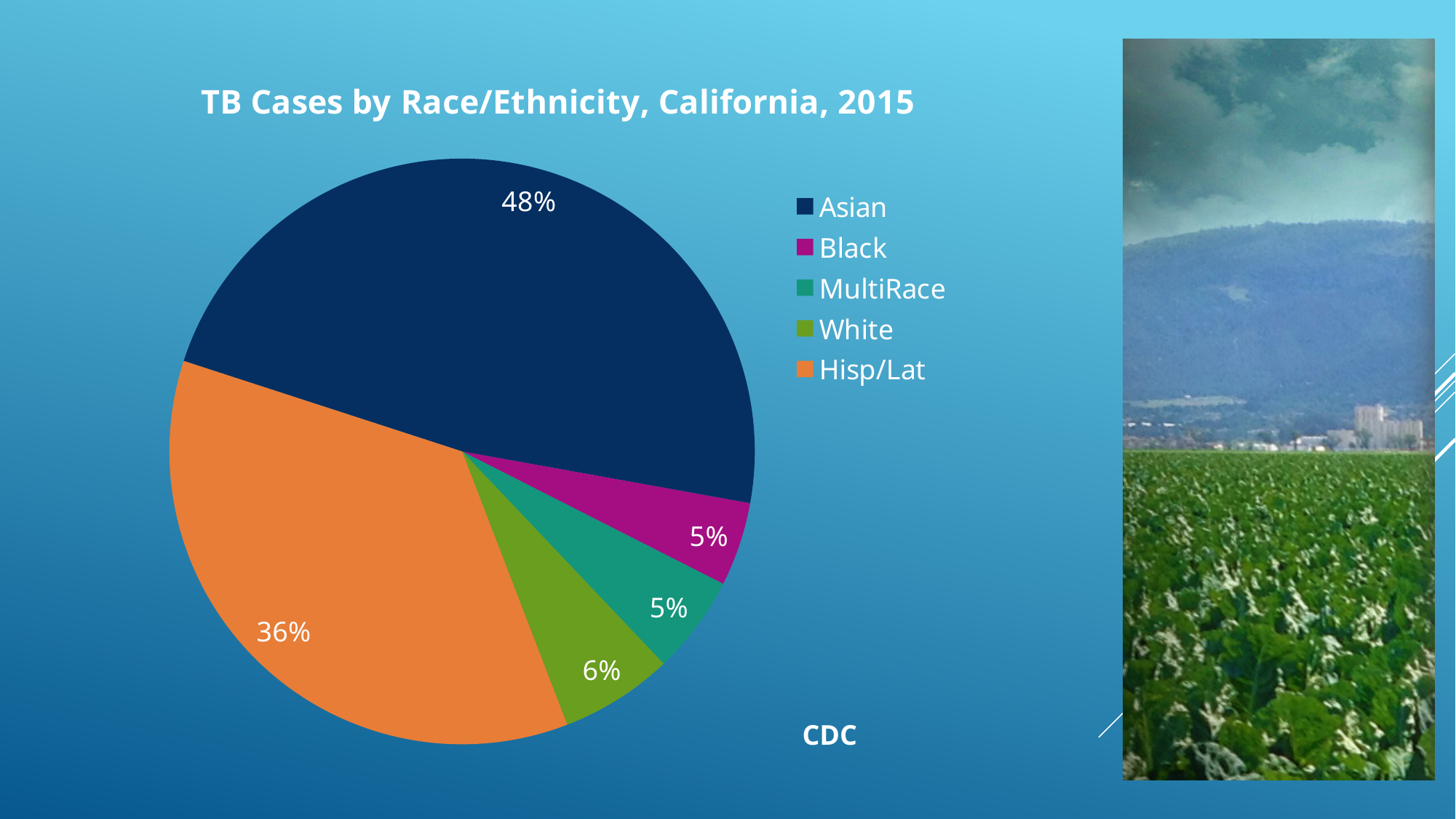
What is the title of the chart? TB Cases by Race/Ethnicity, California, 2015 What percentage of TB cases is shown for Black? 5% What share of TB cases is attributed to Asian in the pie chart? 48% Which slice is larger, White or MultiRace? White Which race/ethnicity group has the largest share of TB cases? Asian How many race/ethnicity categories are shown in the pie chart? 5 What is the difference in percentage points between the Asian and Hisp/Lat slices? 12 What is the combined share of the Asian and Hisp/Lat slices? 84% What percentage of TB cases is shown for White? 6% What share of TB cases is attributed to Hisp/Lat? 36% What type of chart is shown on the slide? Pie chart Which colour represents Hisp/Lat in the pie chart? Orange